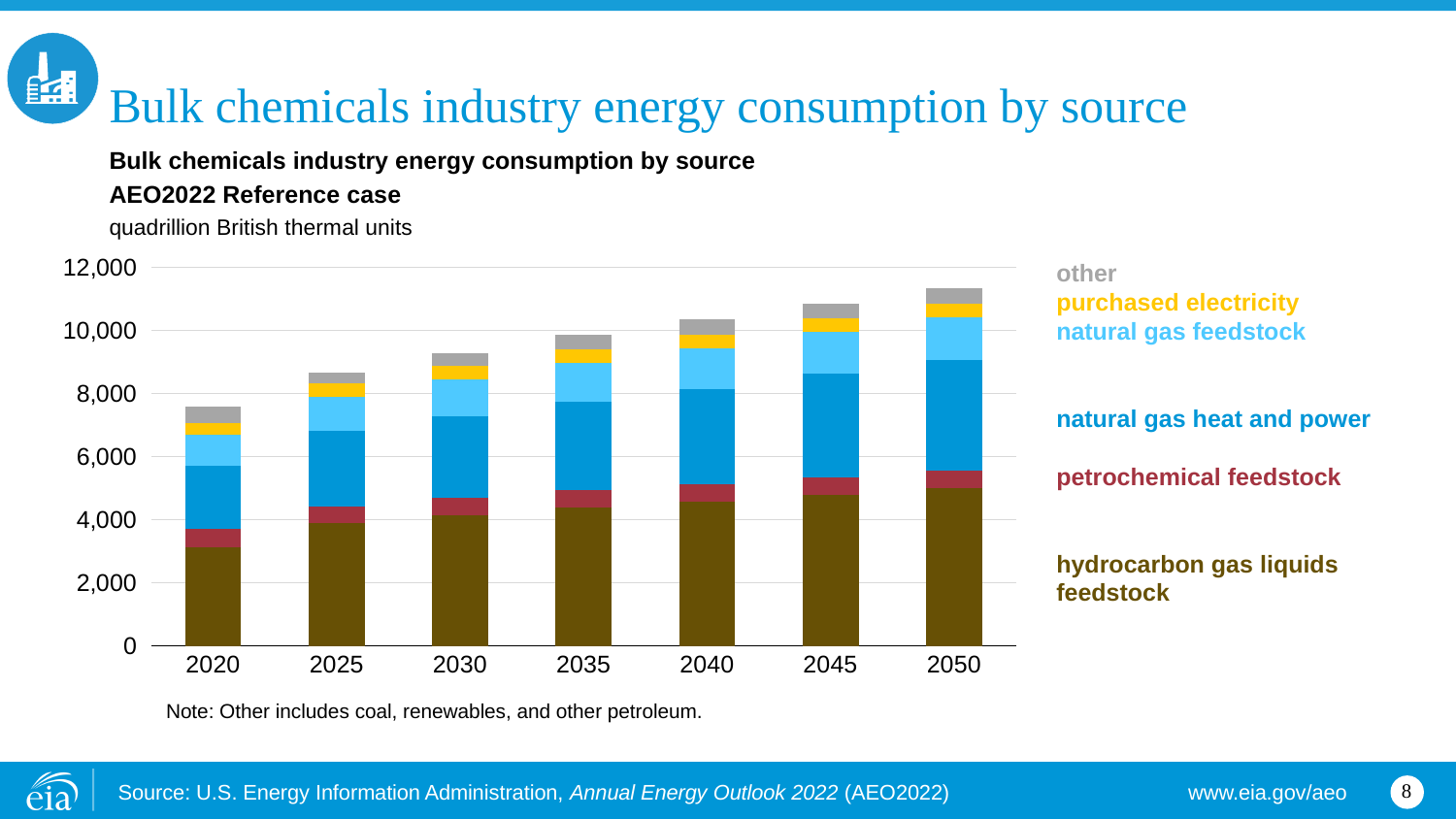
Is the hydrocarbon gas liquids feedstock segment for 2020 greater or less than 4,000? less What unit is the chart's y axis measured in? quadrillion British thermal units Is the total bar height for 2030 greater or less than 10,000? less How many years are shown along the x axis of the chart? 7 Which is larger, the total bar for 2045 or the total bar for 2025? 2045 Which year has the shortest stacked bar (lowest total energy consumption)? 2020 Is the total bar height for 2020 greater or less than 8,000? less Which year has the tallest stacked bar (highest total energy consumption)? 2050 What kind of chart is shown on the slide? stacked bar chart Do the total bar heights rise or fall from 2020 to 2050? rise How many energy sources does the legend list? 6